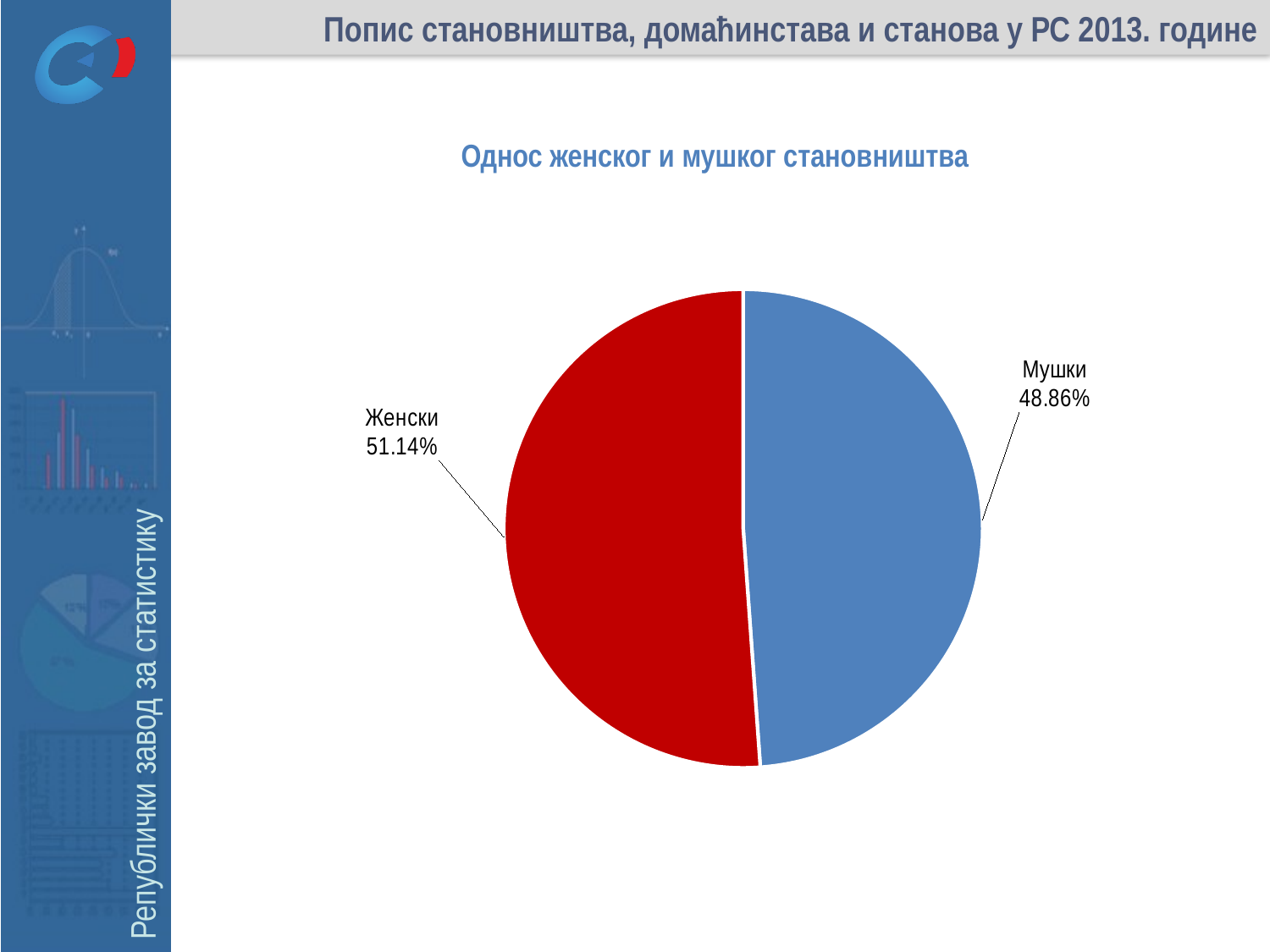
How many slices does the pie chart have? 2 Which is larger, Женски or Мушки? Женски What is the title of the chart? Однос женског и мушког становништва What is the difference between the Женски and Мушки shares? 2.28% What is the value for Женски? 51.14% Which slice is the smallest? Мушки Which slice is the largest? Женски What colour is the Женски slice? red What is the value for Мушки? 48.86% What share of the pie does Мушки represent? 48.86% What kind of chart is shown on the slide? pie chart